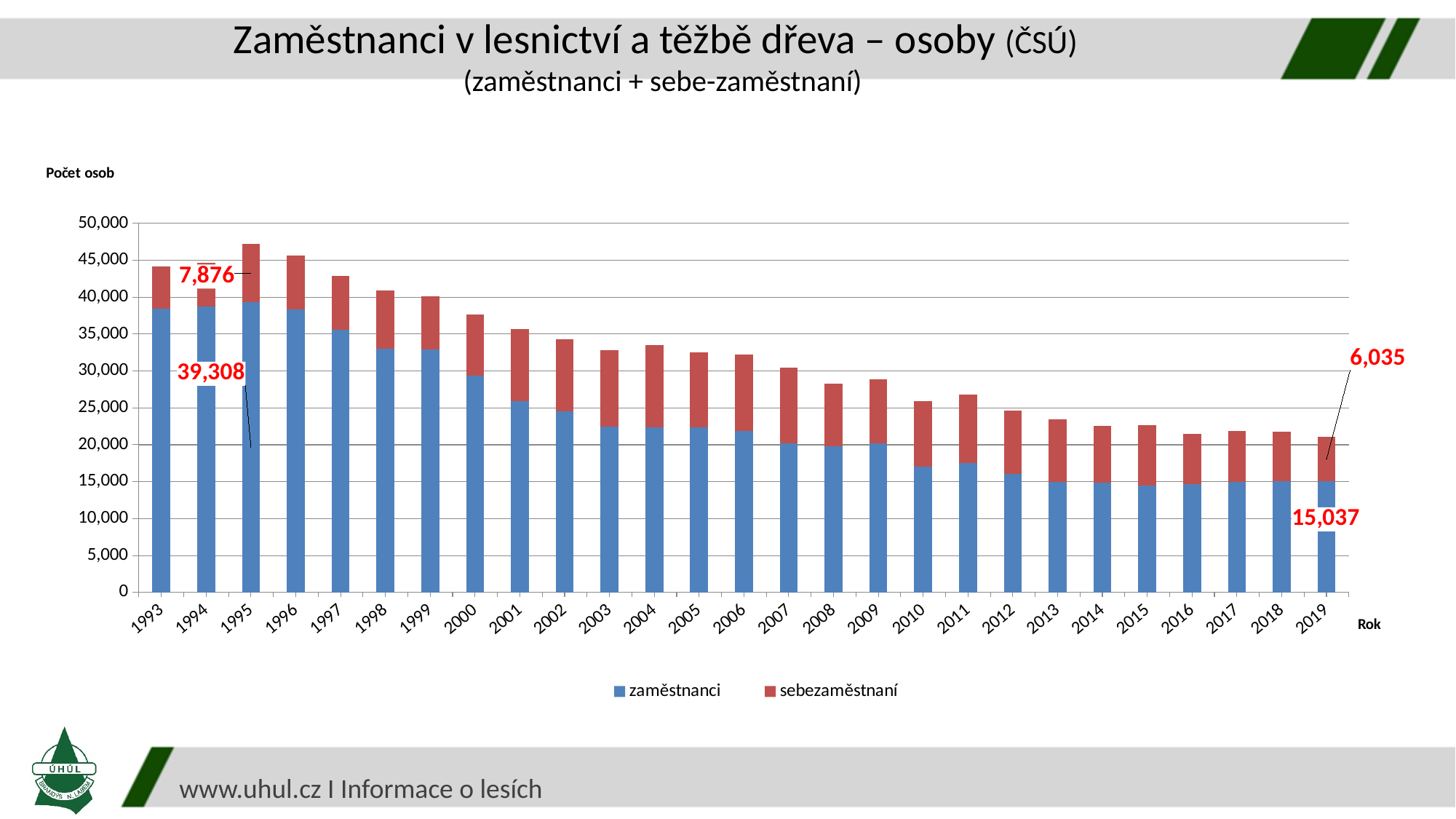
What type of chart is shown on the slide? stacked bar chart What is the value for sebezaměstnaní in 1995? 7,876 What is the value for zaměstnanci in 1995? 39,308 Which year has the highest total bar? 1995 Is the total value for 1993 greater or less than 40,000? greater What is the total of the stacked bar for 1995? 47,184 What is the difference between the zaměstnanci values for 1995 and 2019? 24,271 How many years are shown on the x axis? 27 What is the value for zaměstnanci in 2019? 15,037 How many series does the legend list? 2 What is the total of the stacked bar for 2019? 21,072 What is the value for sebezaměstnaní in 2019? 6,035